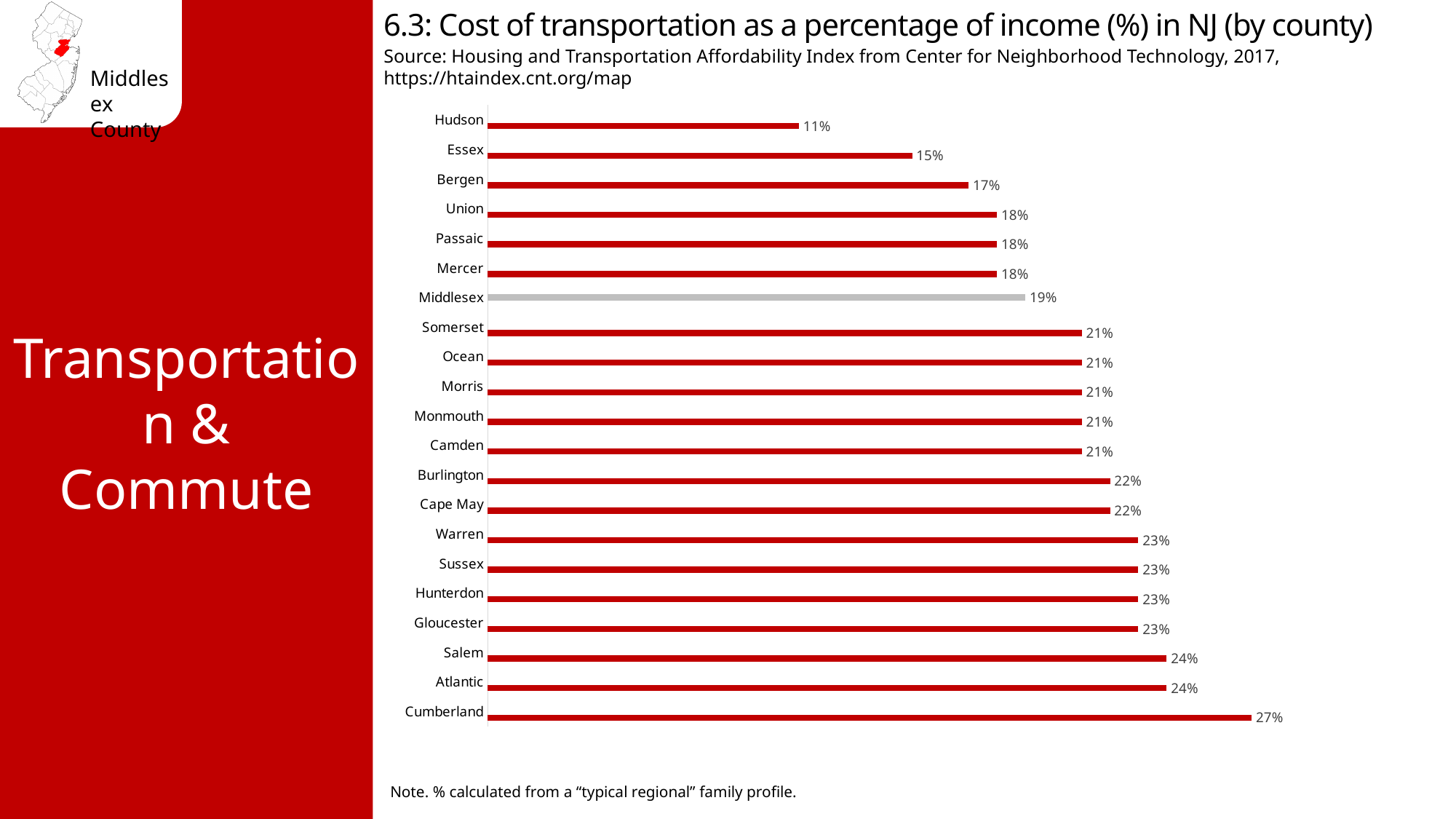
Which county has a higher cost of transportation as a percentage of income, Salem or Union? Salem How many counties are shown in the chart? 21 Which county has the lowest cost of transportation as a percentage of income? Hudson What is the cost of transportation as a percentage of income for Hudson County? 11% What is the difference in percentage points between Cumberland and Hudson? 16 What is the cost of transportation as a percentage of income for Cumberland County? 27% What type of chart is shown on the slide? Bar chart Which county has the highest cost of transportation as a percentage of income? Cumberland What is the cost of transportation as a percentage of income for Bergen County? 17% Which county's bar is shown in grey rather than red? Middlesex What is the difference in percentage points between Middlesex and Essex? 4 What is the cost of transportation as a percentage of income for Middlesex County? 19%